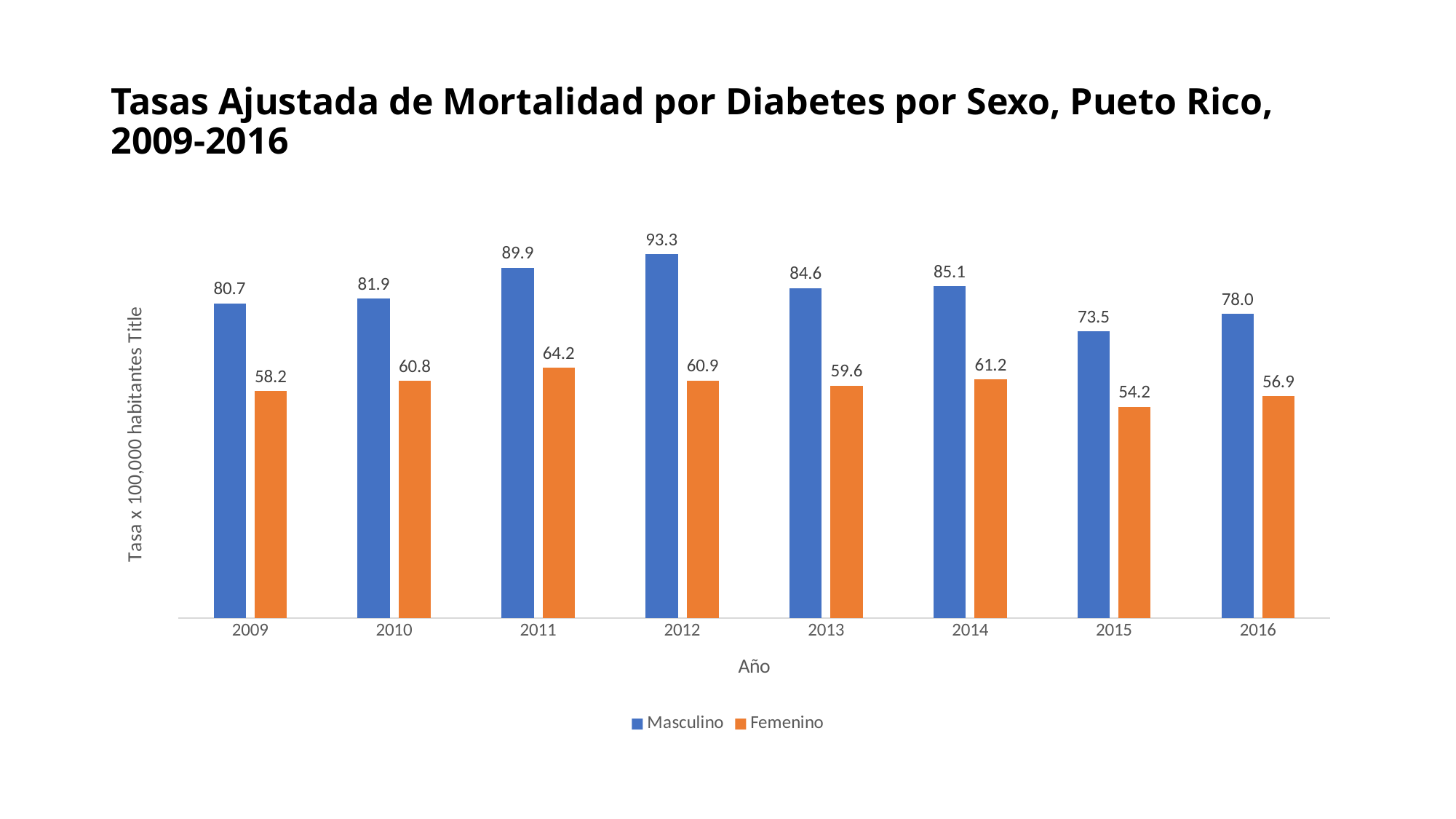
How many years are shown on the x axis? 8 What kind of chart is shown on the slide? Bar chart How many series does the legend list? 2 What is the label of the x axis? Año What is the Masculino value for 2016? 78.0 Which is larger, the Masculino value in 2013 or the Masculino value in 2014? 2014 What is the difference between the Masculino and Femenino values in 2009? 22.5 In which year is the Masculino value highest? 2012 What is the Femenino value for 2015? 54.2 What is the Masculino value for 2012? 93.3 In which year is the Femenino value lowest? 2015 In which year is the Femenino value highest? 2011